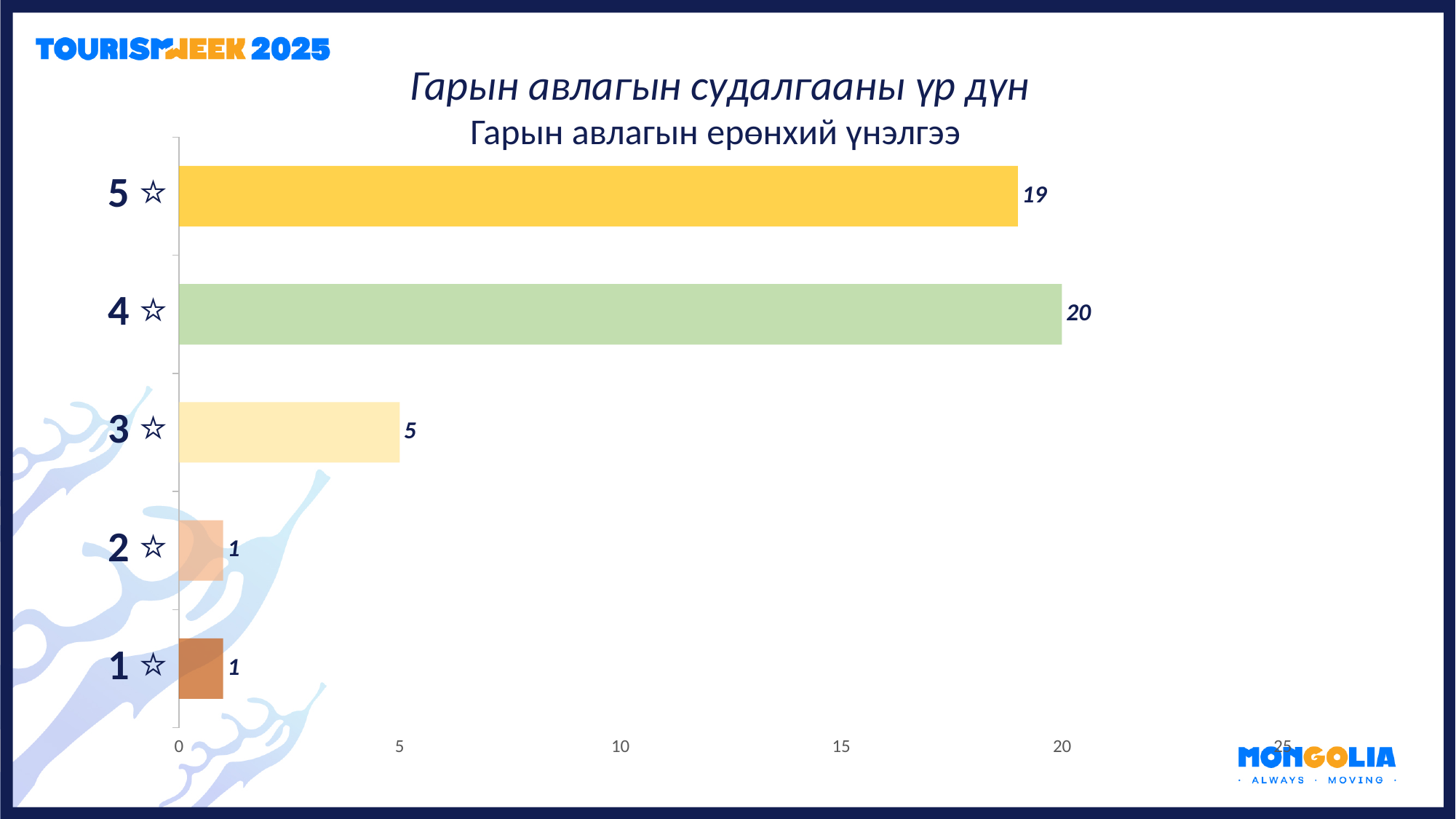
What kind of chart is shown on the slide? bar chart What is the difference between the values for 5 ☆ and 2 ☆? 18 What is the difference between the values for 4 ☆ and 3 ☆? 15 What is the highest tick value shown on the horizontal axis? 25 Which category has the highest value? 4 ☆ What is the value for the 5 ☆ category? 19 What is the value for the 4 ☆ category? 20 How many categories are shown in the chart? 5 Which is larger, the value for 5 ☆ or the value for 3 ☆? 5 ☆ What is the value for the 3 ☆ category? 5 Is the value for 5 ☆ greater or less than 15? greater What is the title of the chart? Гарын авлагын ерөнхий үнэлгээ